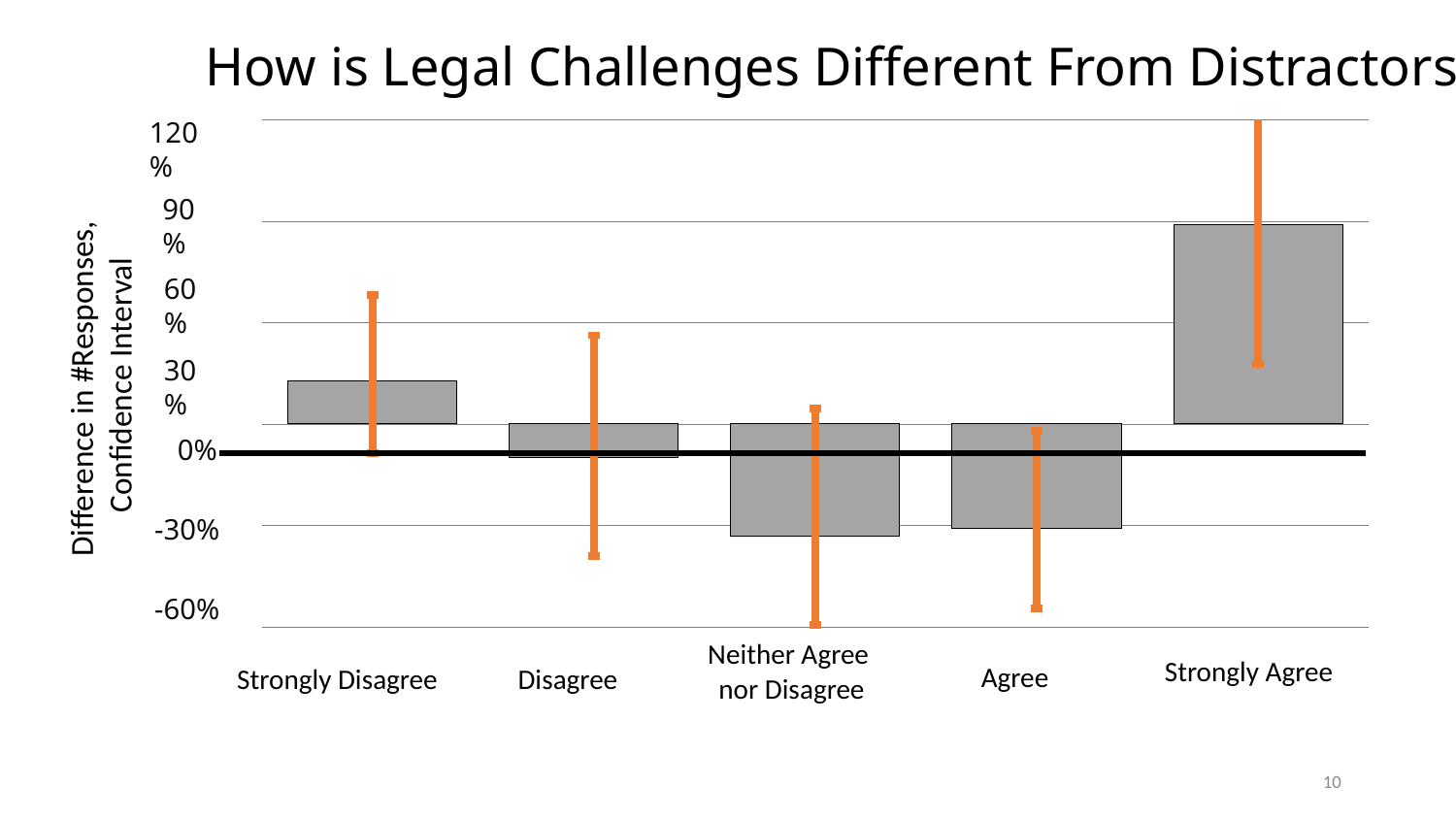
Which is larger, the value for Strongly Agree or the value for Strongly Disagree? Strongly Agree Is the value for Strongly Agree greater or less than 30%? greater Which category has the highest value in the chart? Strongly Agree What is the label on the vertical axis of the chart? Difference in #Responses, Confidence Interval Is the value for Neither Agree nor Disagree greater or less than 0%? less What is the title of the chart on the slide? How is Legal Challenges Different From Distractors Is the value for Strongly Disagree greater or less than 0%? greater How many categories are shown on the x axis of the chart? 5 Which is larger, the value for Strongly Disagree or the value for Disagree? Strongly Disagree Which is larger, the value for Agree or the value for Strongly Agree? Strongly Agree What kind of chart is shown on the slide? bar chart